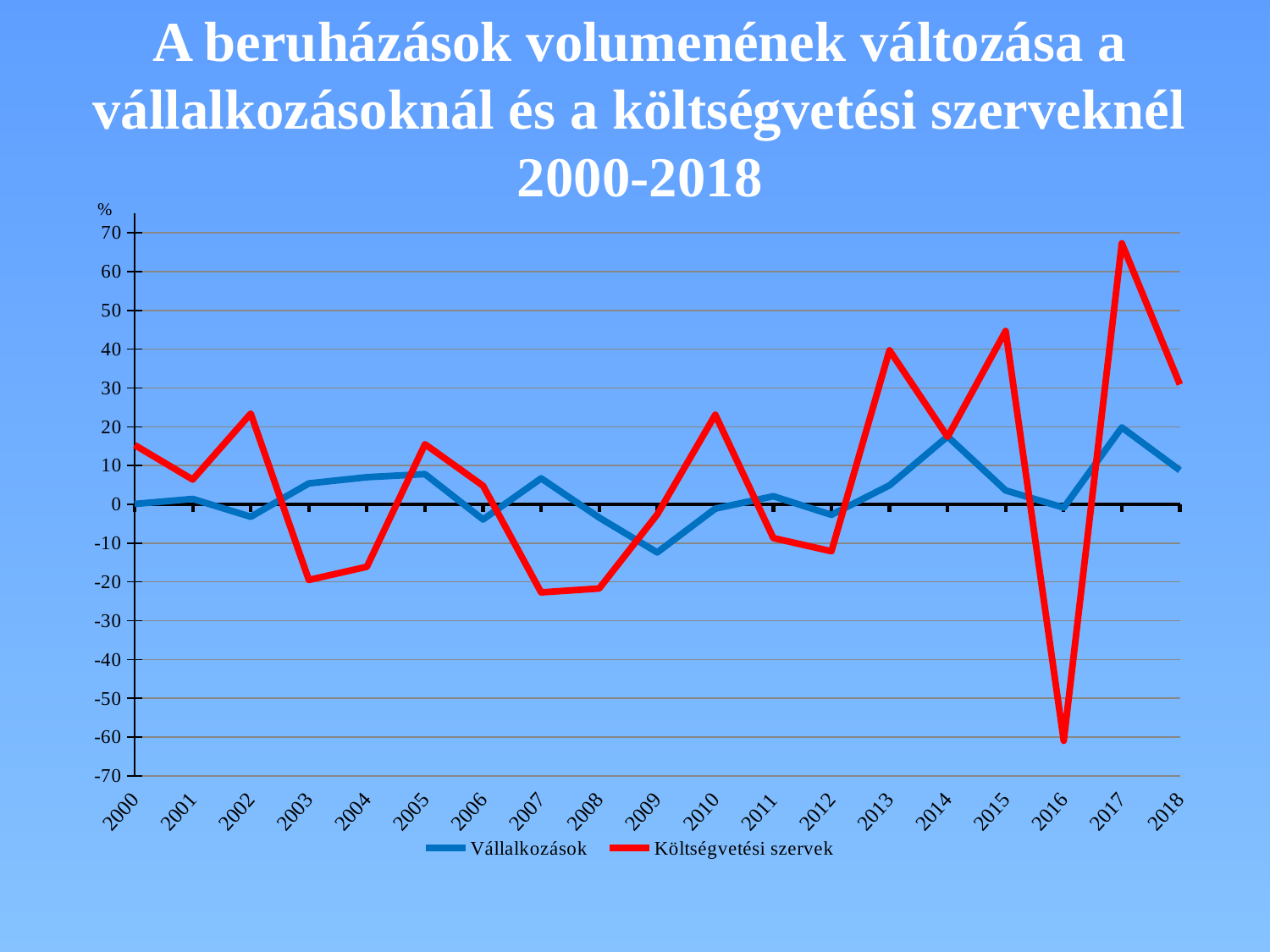
Which series is drawn in red? Költségvetési szervek Is the value for Költségvetési szervek in 2017 greater or less than 60? greater How many years are plotted along the x axis? 19 In which year does the Vállalkozások series reach its lowest value? 2009 Does the Költségvetési szervek series rise or fall from 2017 to 2018? fall Is the value for Költségvetési szervek in 2016 greater or less than -50? less What kind of chart is shown on the slide? line chart Is the value for Vállalkozások in 2017 greater or less than 10? greater In 2016, which series has the larger value, Vállalkozások or Költségvetési szervek? Vállalkozások In which year does the Költségvetési szervek series reach its lowest value? 2016 In which year does the Költségvetési szervek series reach its highest value? 2017 How many series does the legend list? 2